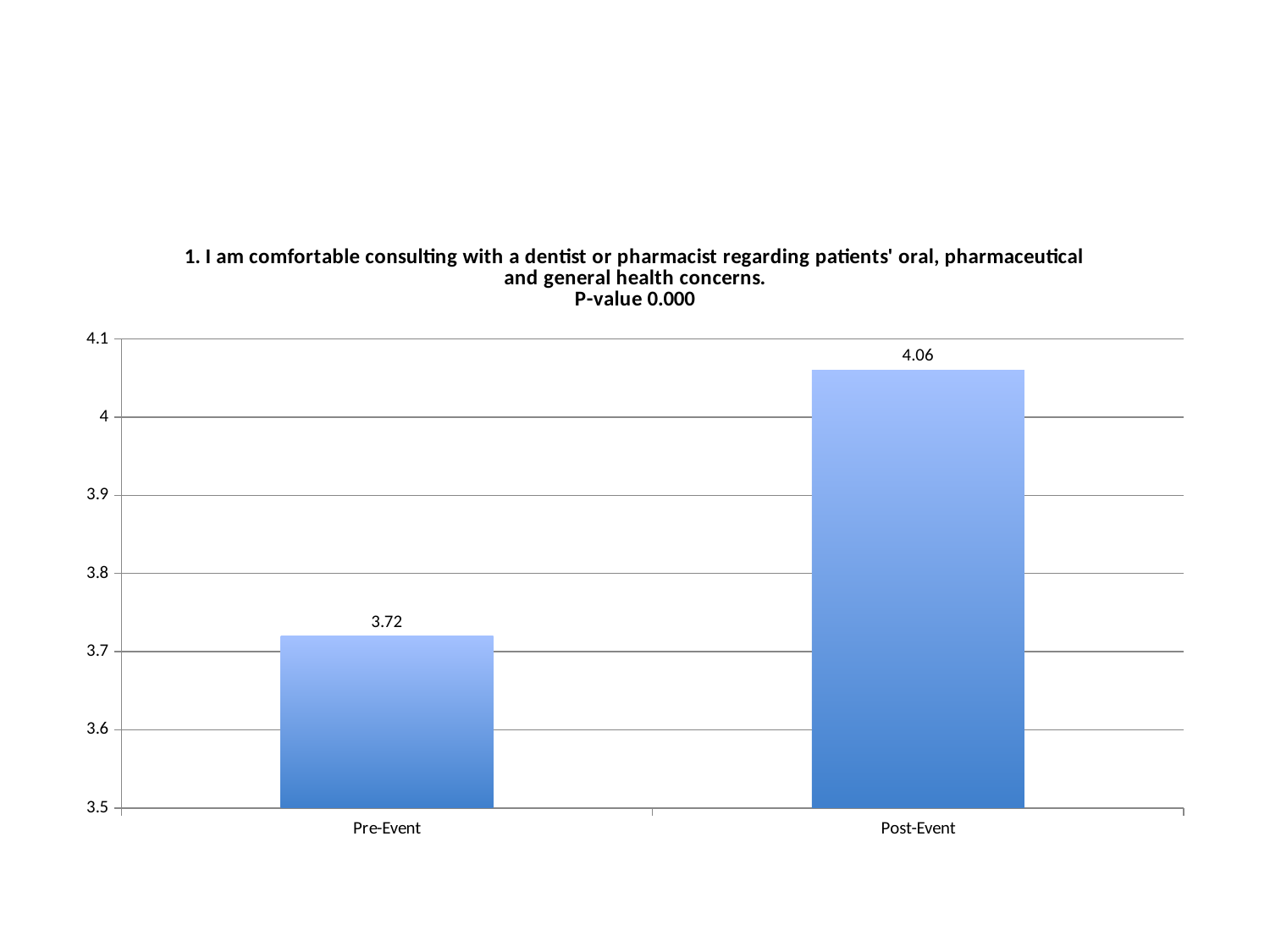
Which category has the highest value? Post-Event Do the values rise or fall from Pre-Event to Post-Event? Rise Is the value for Post-Event greater or less than 4? greater Which is larger, the Pre-Event value or the Post-Event value? Post-Event What is the difference between the Post-Event and Pre-Event values? 0.34 What P-value is stated in the chart title? 0.000 What kind of chart is shown on the slide? Bar chart What is the value for Pre-Event? 3.72 How many categories are shown on the x axis? 2 Is the value for Pre-Event greater or less than 3.8? less Which category has the lowest value? Pre-Event What is the value for Post-Event? 4.06